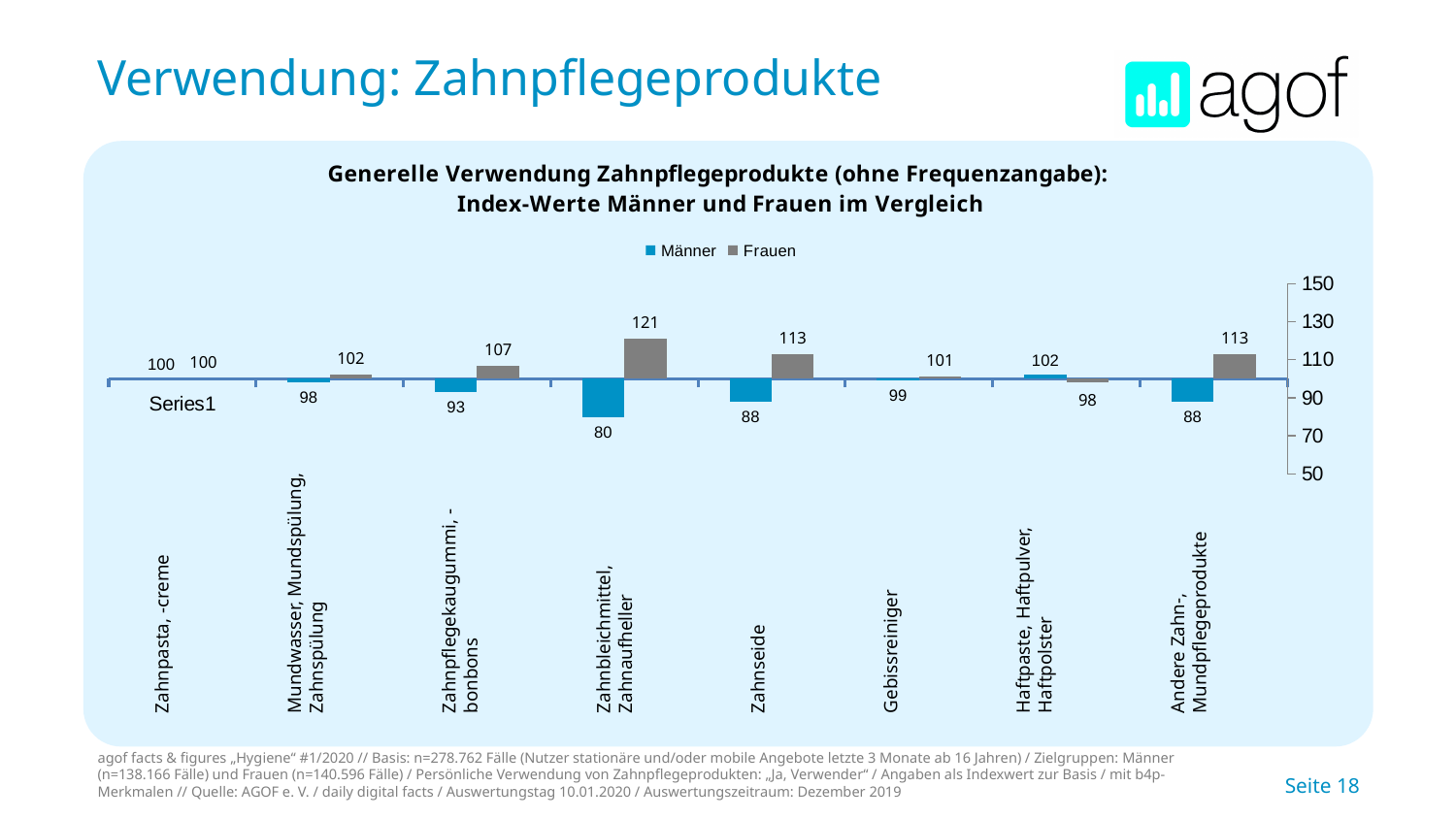
How many product categories are shown on the x axis? 8 What kind of chart is shown on the slide? Bar chart What is the Frauen index value for Zahnseide? 113 Which series is shown in blue in the legend? Männer Which category has the lowest Männer index value? Zahnbleichmittel, Zahnaufheller Which category has the highest Frauen index value? Zahnbleichmittel, Zahnaufheller What is the Frauen index value for Zahnpflegekaugummi, -bonbons? 107 What is the Männer index value for Haftpaste, Haftpulver, Haftpolster? 102 What is the difference between the Frauen and Männer index values for Zahnbleichmittel, Zahnaufheller? 41 What is the Männer index value for Zahnbleichmittel, Zahnaufheller? 80 How many series does the legend list? 2 For Haftpaste, Haftpulver, Haftpolster, which series has the larger index value, Männer or Frauen? Männer